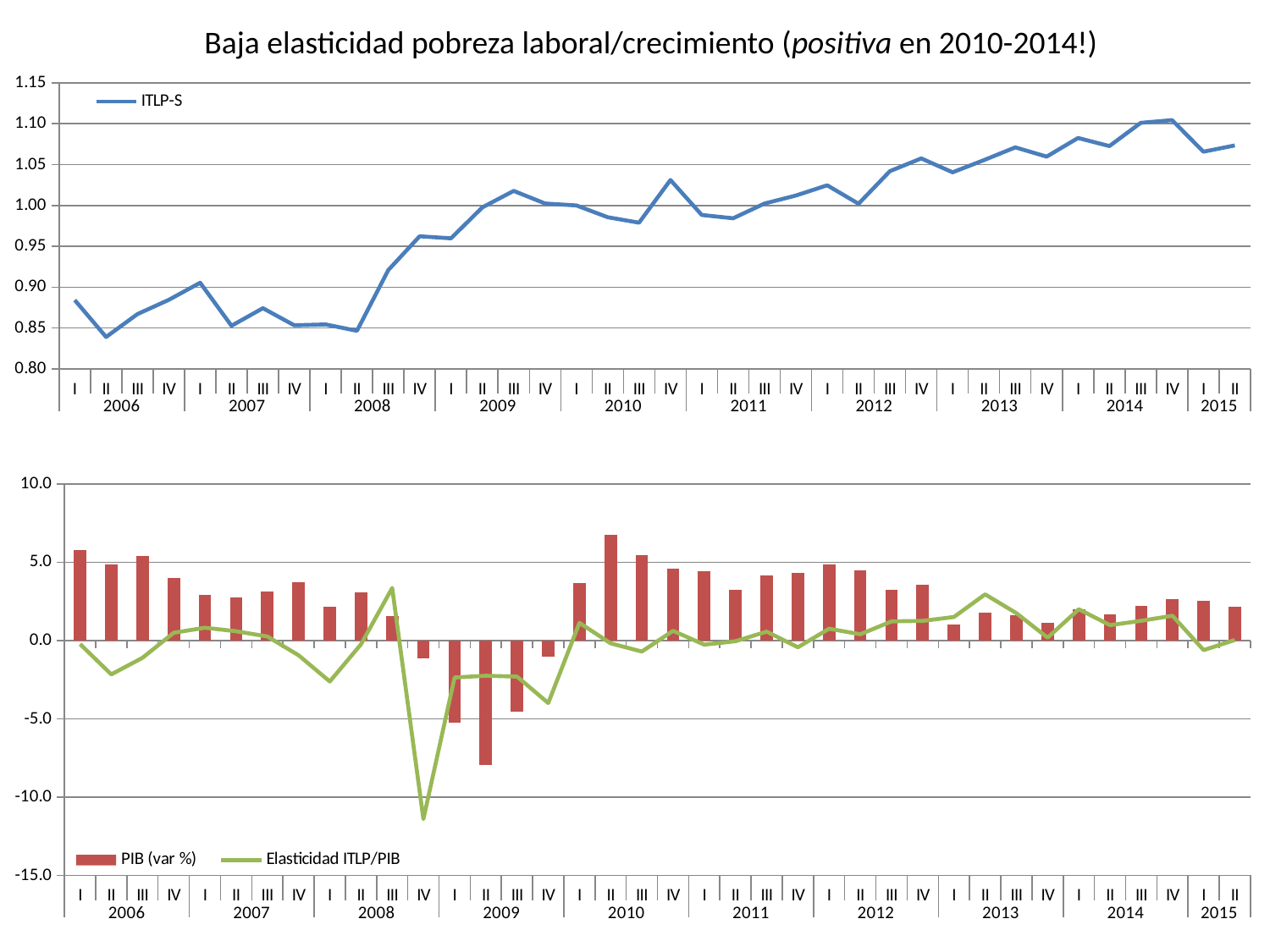
In the top chart, is the ITLP-S value for 2008 II greater or less than 0.90? less In the bottom chart, which quarter has the lowest PIB (var %) bar? 2009 II In the top chart, is the ITLP-S value for 2010 IV greater or less than 1.00? greater In the bottom chart, which quarter has the highest PIB (var %) bar? 2010 II What kind of chart is the bottom chart? Combination bar and line chart In the bottom chart, which is larger: the PIB (var %) bar for 2006 I or for 2007 I? 2006 I How many series does the legend of the top chart list? 1 In the bottom chart, is the Elasticidad ITLP/PIB value for 2008 IV greater or less than -10.0? less In the top chart, does the ITLP-S series overall rise or fall from 2006 to 2015? rise How many series does the legend of the bottom chart list? 2 In the bottom chart, which quarter has the lowest value of Elasticidad ITLP/PIB? 2008 IV What kind of chart is the top chart (ITLP-S)? Line chart